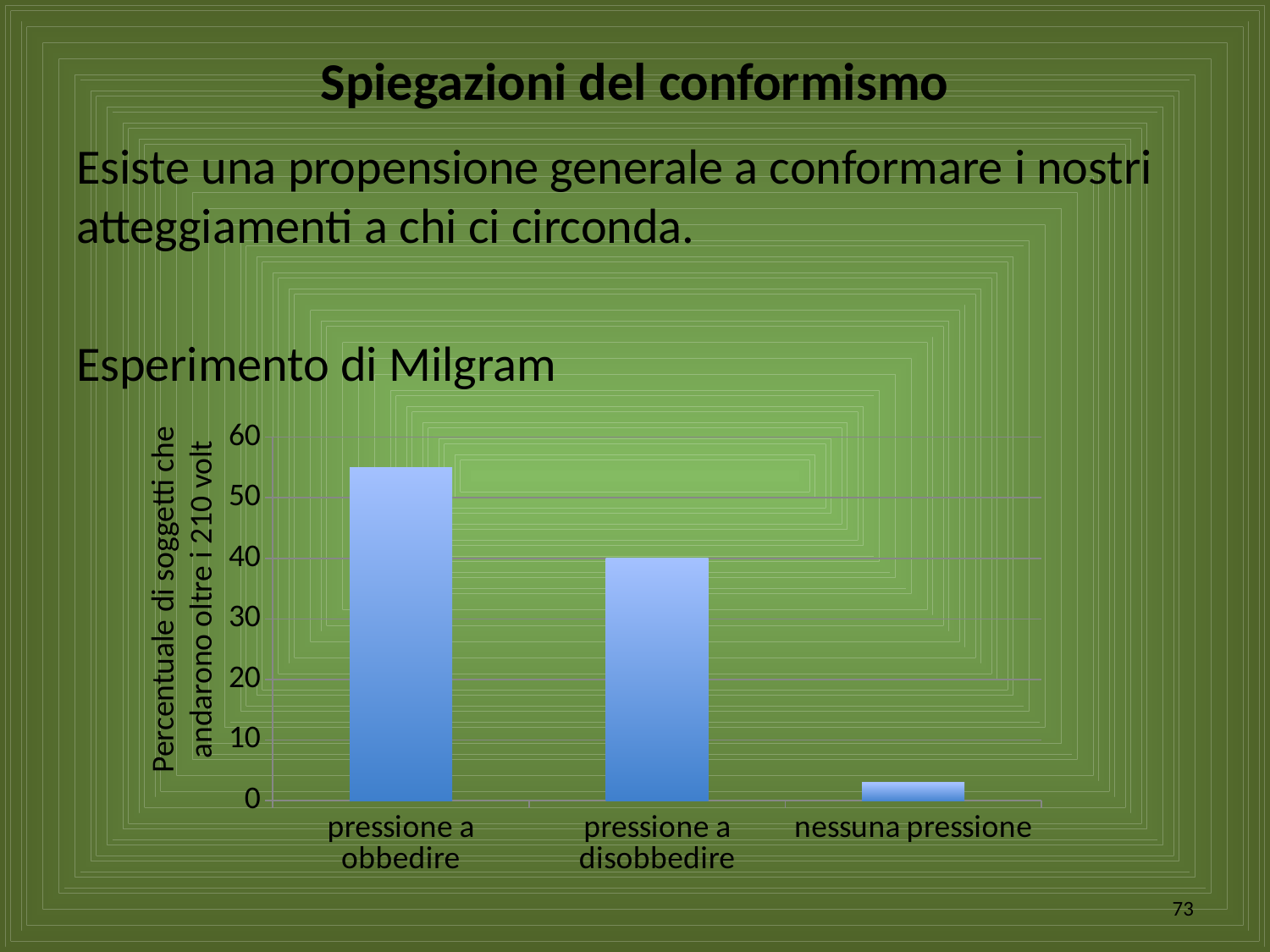
Is the value for "pressione a obbedire" greater or less than 60? less What kind of chart is shown on the slide? bar chart What is the highest value shown on the vertical axis of the chart? 60 What is the label of the vertical axis of the chart? Percentuale di soggetti che andarono oltre i 210 volt Do the bar values rise or fall from left to right along the x axis? fall Which is larger, the value for "pressione a obbedire" or the value for "pressione a disobbedire"? pressione a obbedire Which category has the lowest bar? nessuna pressione Which category has the highest bar? pressione a obbedire Is the value for "nessuna pressione" greater or less than 10? less What is the value for "pressione a disobbedire"? 40 Is the value for "pressione a obbedire" greater or less than 50? greater How many categories are shown on the x axis of the chart? 3